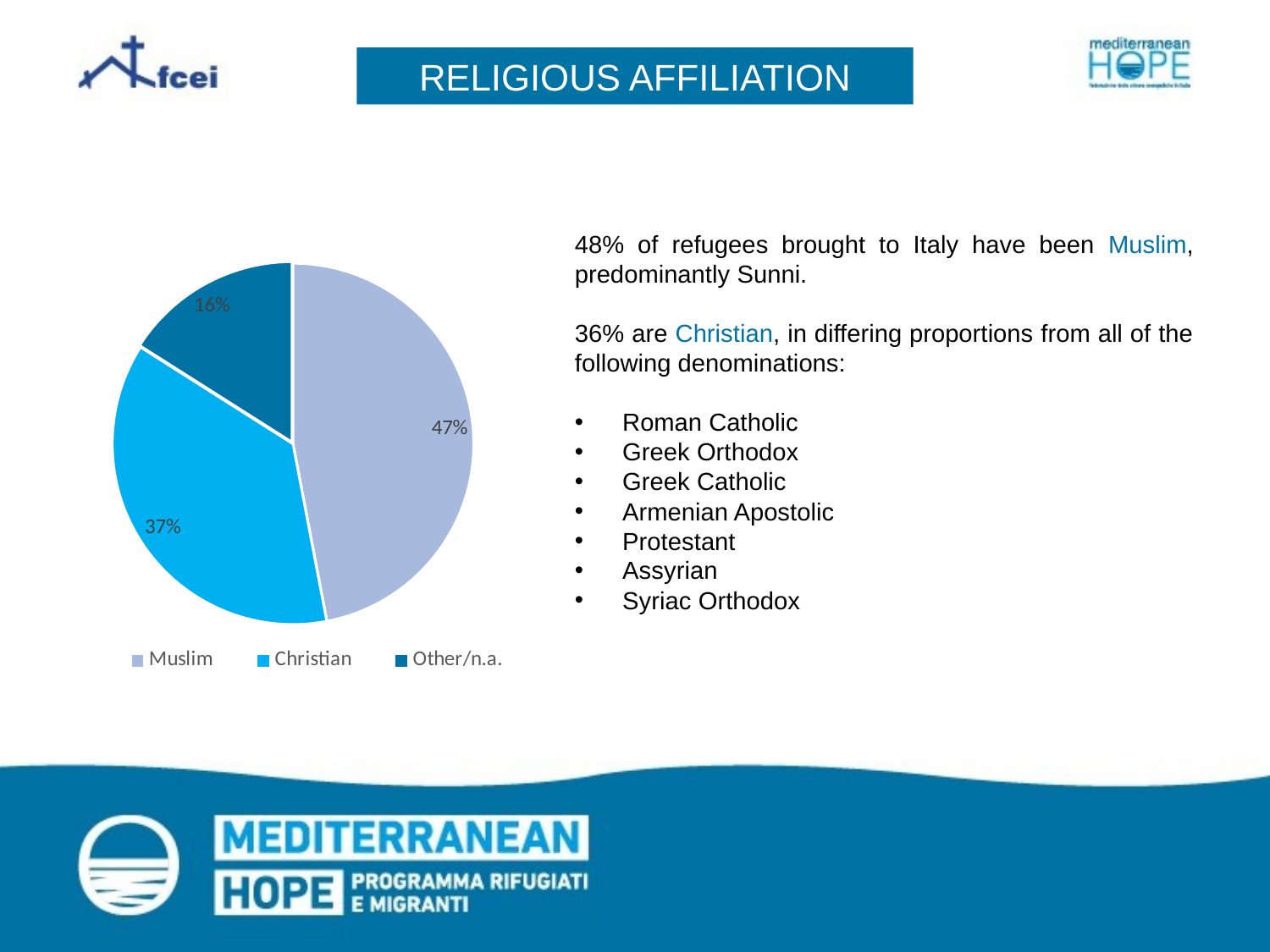
What share of the pie does the Other/n.a. slice represent? 16% Which category has the smallest slice of the pie? Other/n.a. Which legend entry is shown in the darkest blue colour? Other/n.a. What share of the pie does the Muslim slice represent? 47% What kind of chart is shown on the slide? Pie chart How many categories does the pie chart show? 3 What are the three legend entries of the pie chart? Muslim, Christian, Other/n.a. What is the difference in percentage points between the Muslim and Christian slices? 10 What is the difference in percentage points between the Christian and Other/n.a. slices? 21 Which category has the largest slice of the pie? Muslim What share of the pie does the Christian slice represent? 37% Which slice is larger, Christian or Other/n.a.? Christian